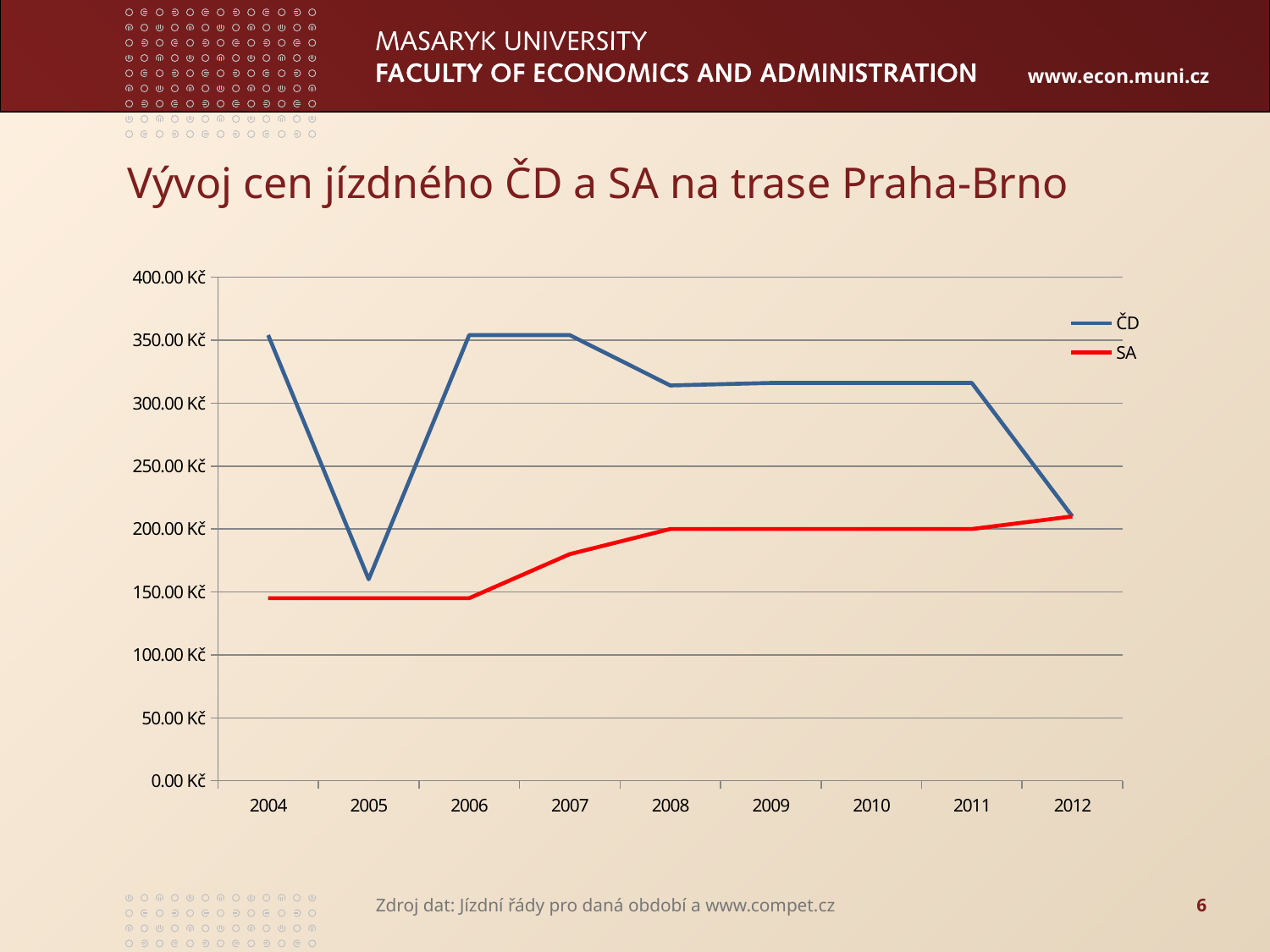
Which colour is used for the SA line? red In which year is the ČD fare at its lowest? 2005 Does the SA fare generally rise or fall from 2004 to 2012? rise Is the ČD fare in 2004 greater or less than 300.00 Kč? greater How many series does the legend list? 2 Is the SA fare in 2007 greater or less than 150.00 Kč? greater In which year is the SA fare at its highest? 2012 Is the ČD fare in 2005 greater or less than 200.00 Kč? less What kind of chart is shown on the slide? line chart How many years are shown on the x axis? 9 Which fare was higher in 2008, ČD or SA? ČD